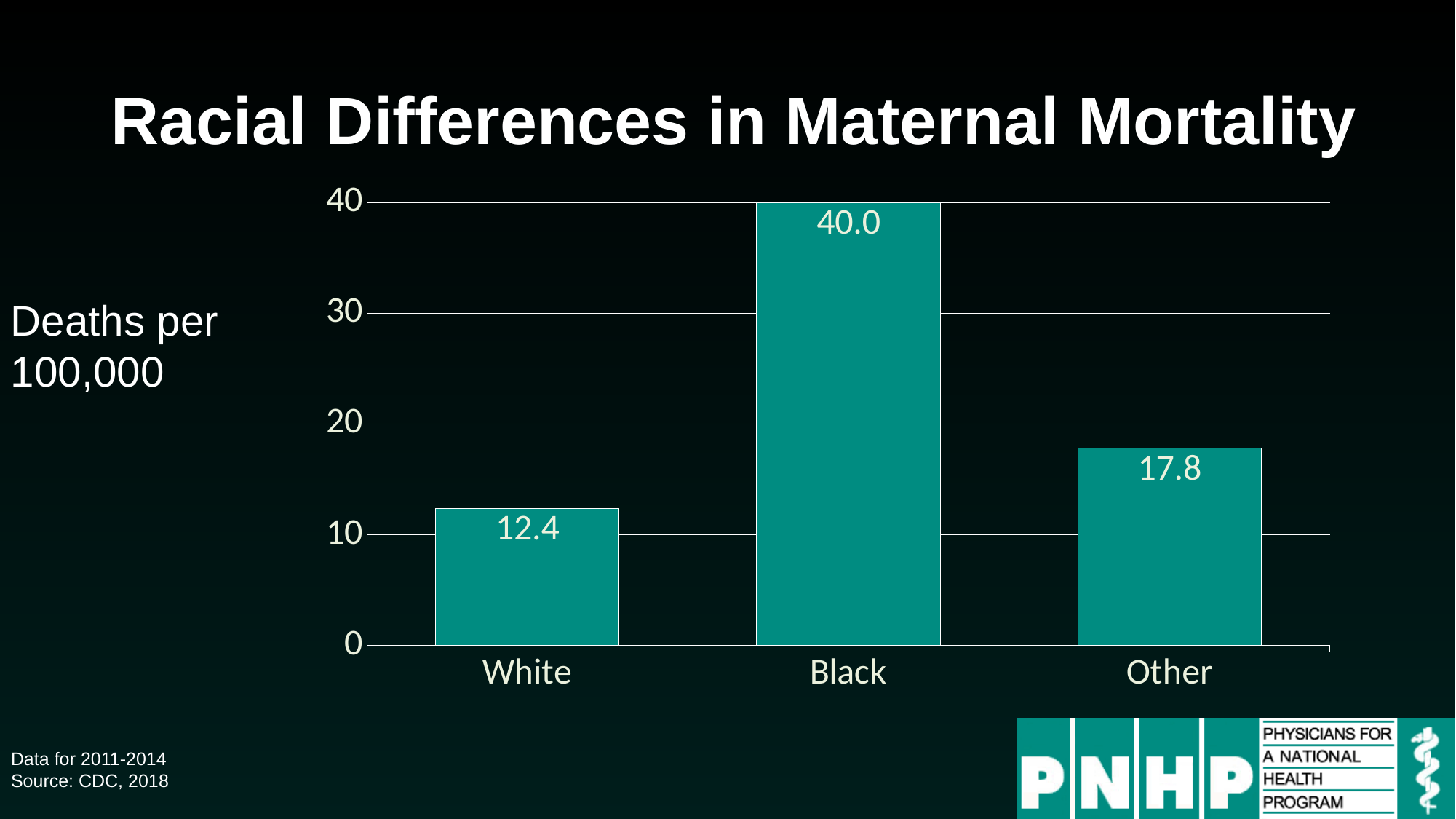
What is the maternal mortality rate (deaths per 100,000) for Black? 40.0 Which racial group has the highest maternal mortality rate? Black What is the difference between the maternal mortality rates for Black and White? 27.6 What is the difference between the maternal mortality rates for Other and White? 5.4 What is the maternal mortality rate (deaths per 100,000) for White? 12.4 How many racial groups are shown on the chart? 3 What is the title of the chart on the slide? Racial Differences in Maternal Mortality Is the value for Other greater or less than 20? less Which racial group has the lowest maternal mortality rate? White What kind of chart is shown on the slide? Bar chart Which has a higher maternal mortality rate, Other or White? Other What is the maternal mortality rate (deaths per 100,000) for Other? 17.8